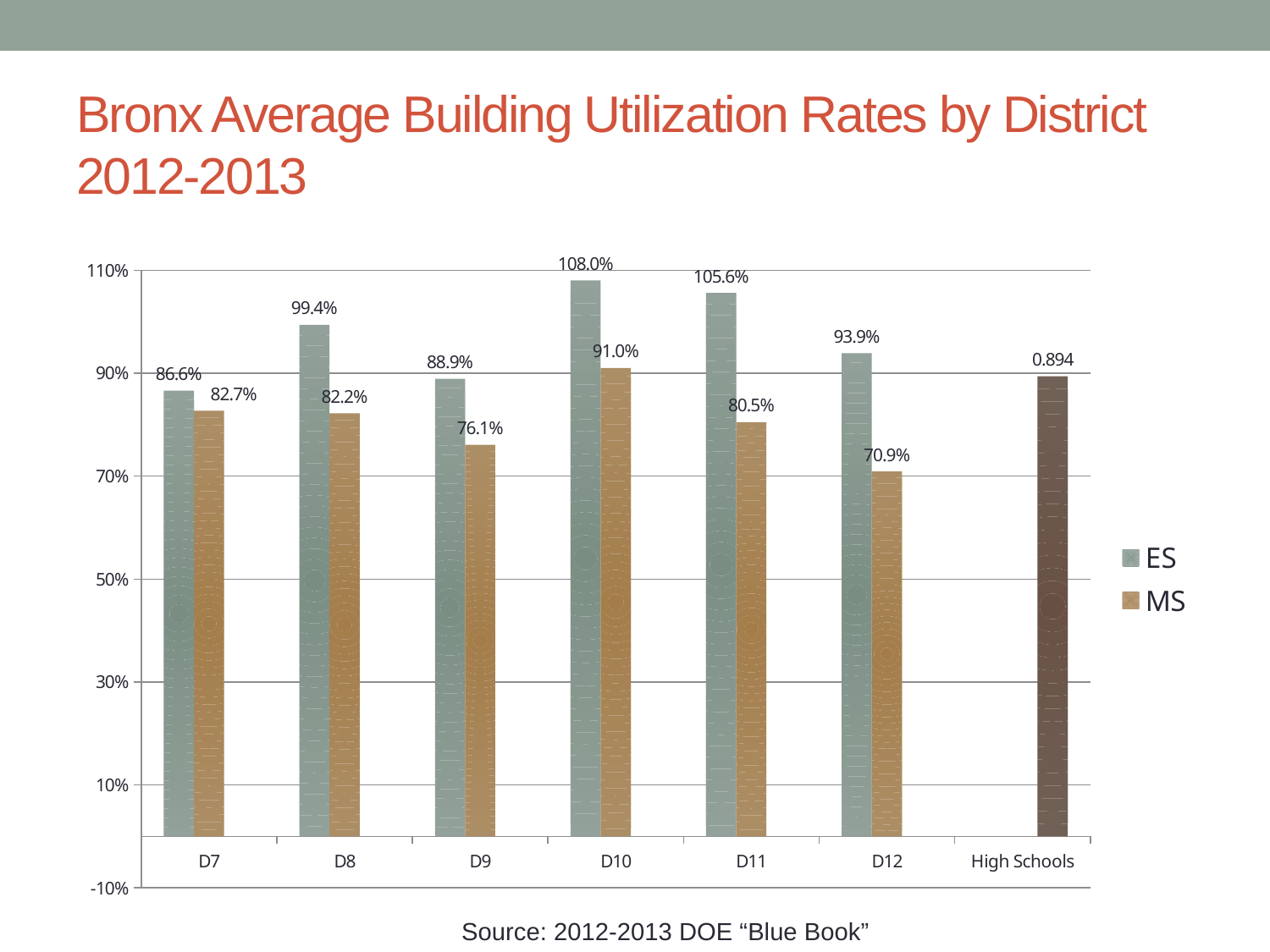
How many series does the legend list? 2 How many categories are shown on the x axis? 7 What is the MS utilization rate for D9? 76.1% Which district has the highest ES utilization rate? D10 Which is larger, the MS rate for D7 or the MS rate for D8? D7 (82.7%) What kind of chart is shown on the slide? Bar chart What is the difference between the ES and MS rates for D12? 23.0% What value is labeled on the High Schools bar? 0.894 What is the ES utilization rate for D10? 108.0% What is the source cited below the chart? 2012-2013 DOE "Blue Book" Is the ES value for D11 greater or less than 90%? greater Which district has the lowest MS utilization rate? D12